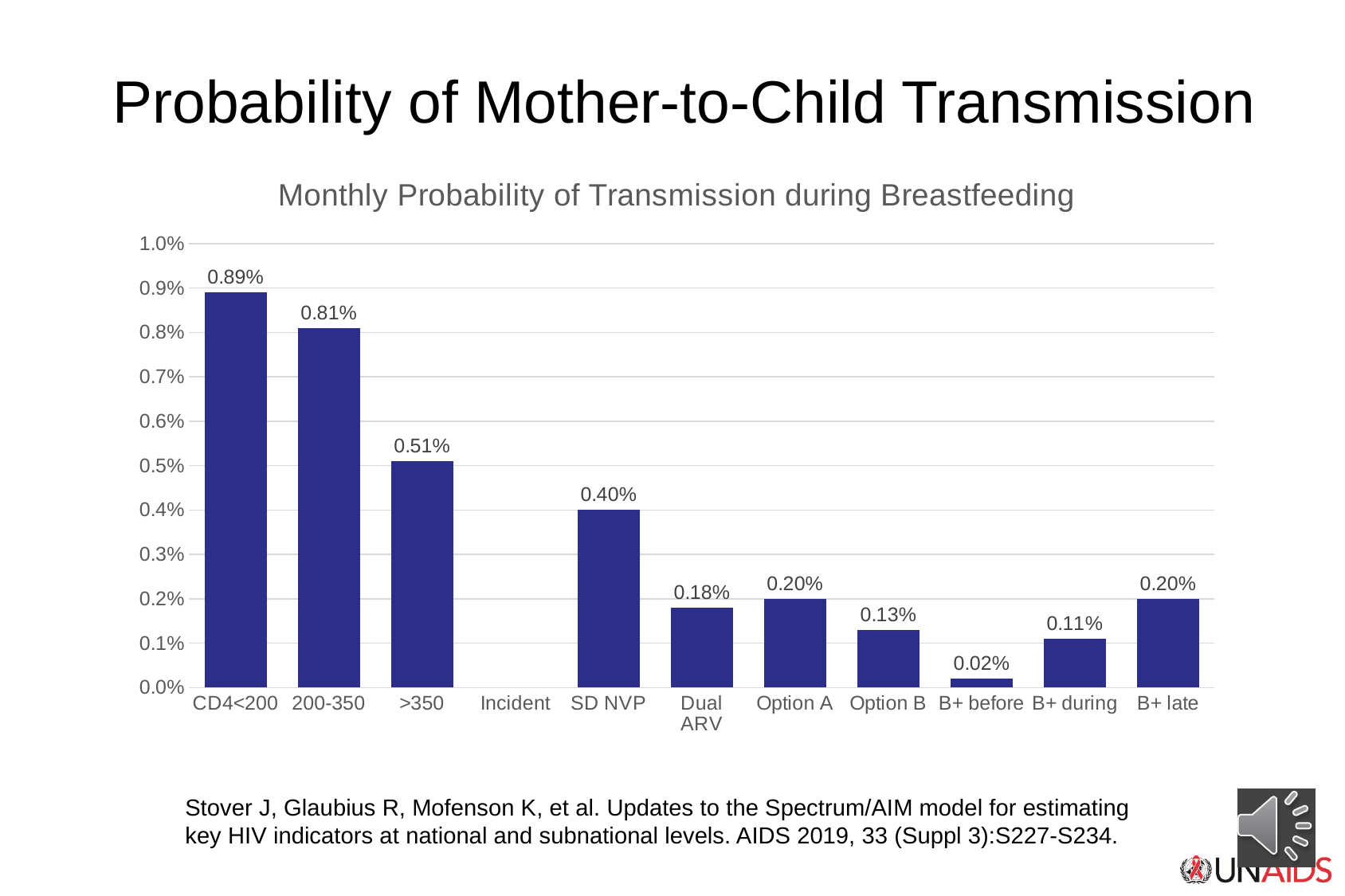
What is the monthly probability of transmission during breastfeeding for CD4<200? 0.89% What value is shown for SD NVP? 0.40% Is the value for SD NVP greater or less than 0.5%? less What value is shown for Option B? 0.13% Which is larger, the value for Dual ARV or the value for Option A? Option A What kind of chart is shown on the slide? Bar chart What is the difference between the values for >350 and SD NVP? 0.11% What is the difference between the values for CD4<200 and 200-350? 0.08% How many categories are labelled on the x axis? 11 Which category has the smallest labelled value? B+ before Which category has the highest monthly probability of transmission? CD4<200 What is the value for B+ before? 0.02%